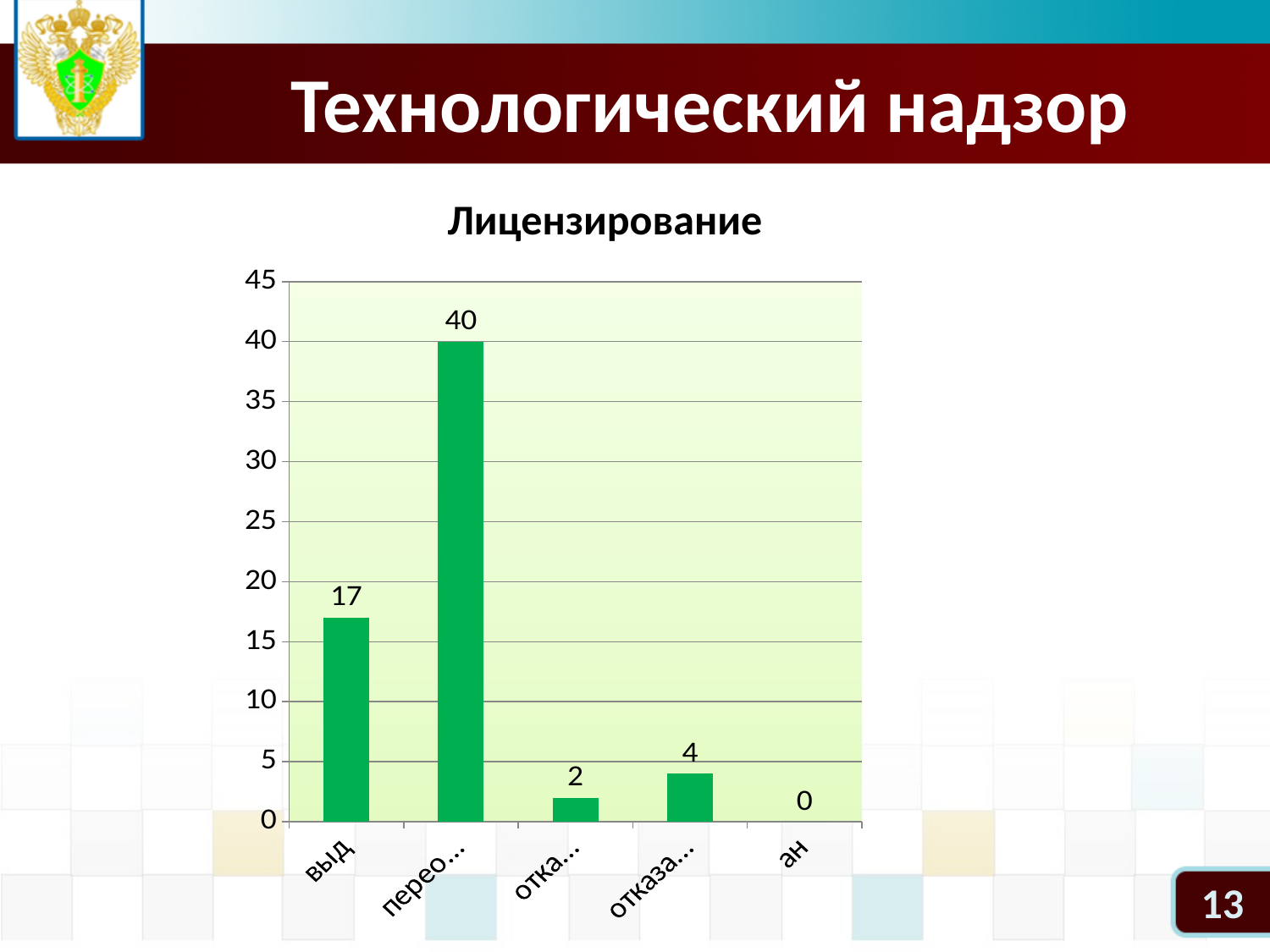
What is the value of the second bar in the "Лицензирование" chart? 40 What is the difference between the second bar (40) and the first bar (17) in the "Лицензирование" chart? 23 What is the value of the fourth bar in the "Лицензирование" chart? 4 Which bar has the lowest value in the "Лицензирование" chart? the last bar (ан) Which bar has the highest value in the "Лицензирование" chart? the second bar (перео...) How many bars are plotted in the "Лицензирование" chart? 5 What is the title of the chart on the slide? Лицензирование What is the value of the last bar (labelled "ан") in the "Лицензирование" chart? 0 What is the value of the first bar (labelled "выд") in the "Лицензирование" chart? 17 What type of chart is shown under the title "Лицензирование"? bar chart Which is larger in the "Лицензирование" chart: the third bar or the fourth bar? the fourth bar What is the value of the third bar in the "Лицензирование" chart? 2